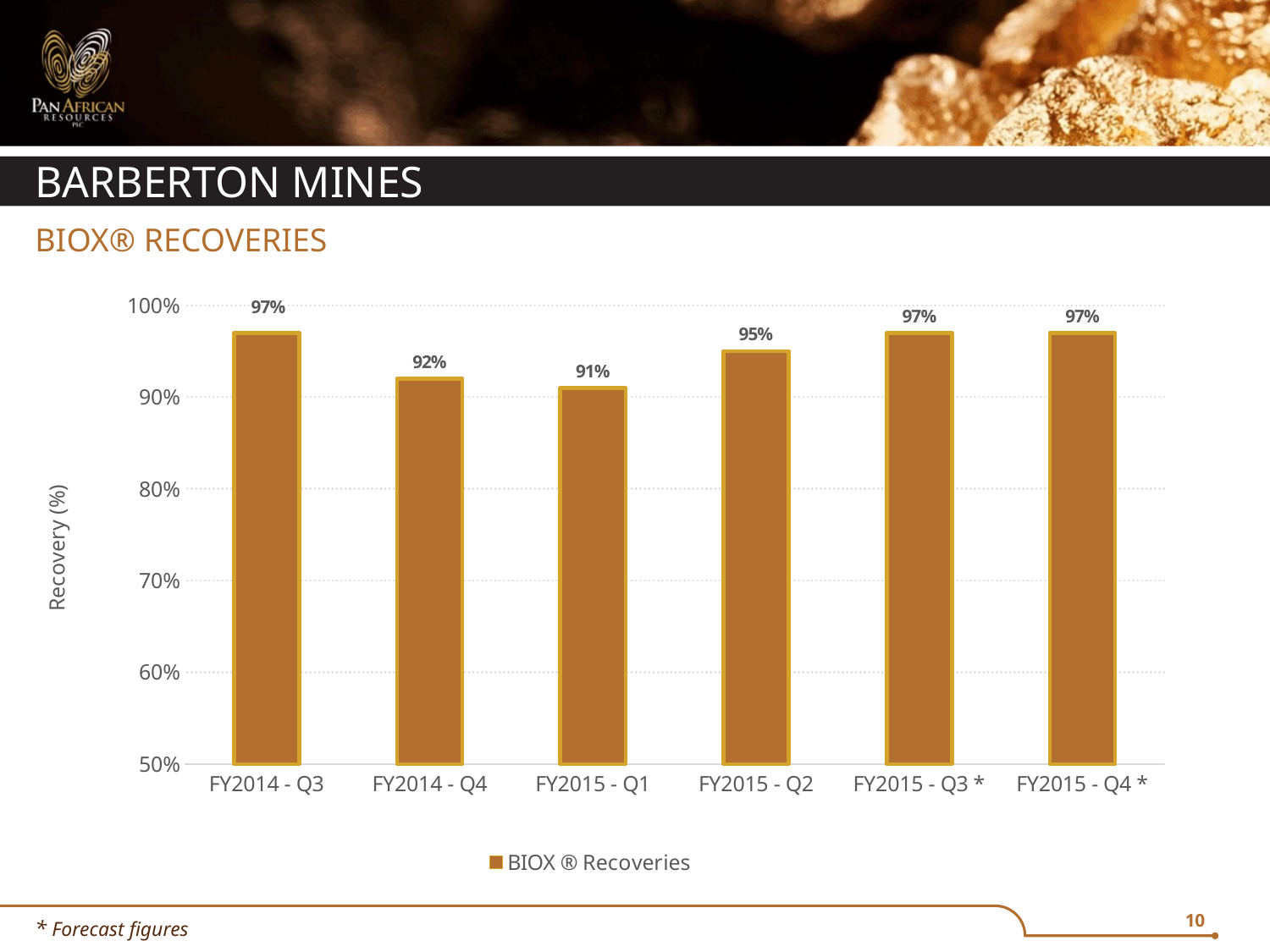
What kind of chart is shown on the slide? Bar chart What is the difference between the BIOX recovery for FY2014 - Q3 and FY2014 - Q4? 5% Which quarter has the lowest BIOX recovery? FY2015 - Q1 What is the BIOX recovery value for FY2015 - Q2? 95% What is the BIOX recovery value for FY2014 - Q4? 92% What is the difference between the BIOX recovery for FY2015 - Q2 and FY2015 - Q1? 4% Which is larger, the BIOX recovery for FY2014 - Q4 or FY2015 - Q2? FY2015 - Q2 How many quarters are shown on the chart? 6 What is the BIOX recovery value for FY2014 - Q3? 97% What is the label on the vertical axis of the chart? Recovery (%) Is the BIOX recovery for FY2015 - Q1 greater or less than 90%? greater What is the BIOX recovery value for FY2015 - Q1? 91%